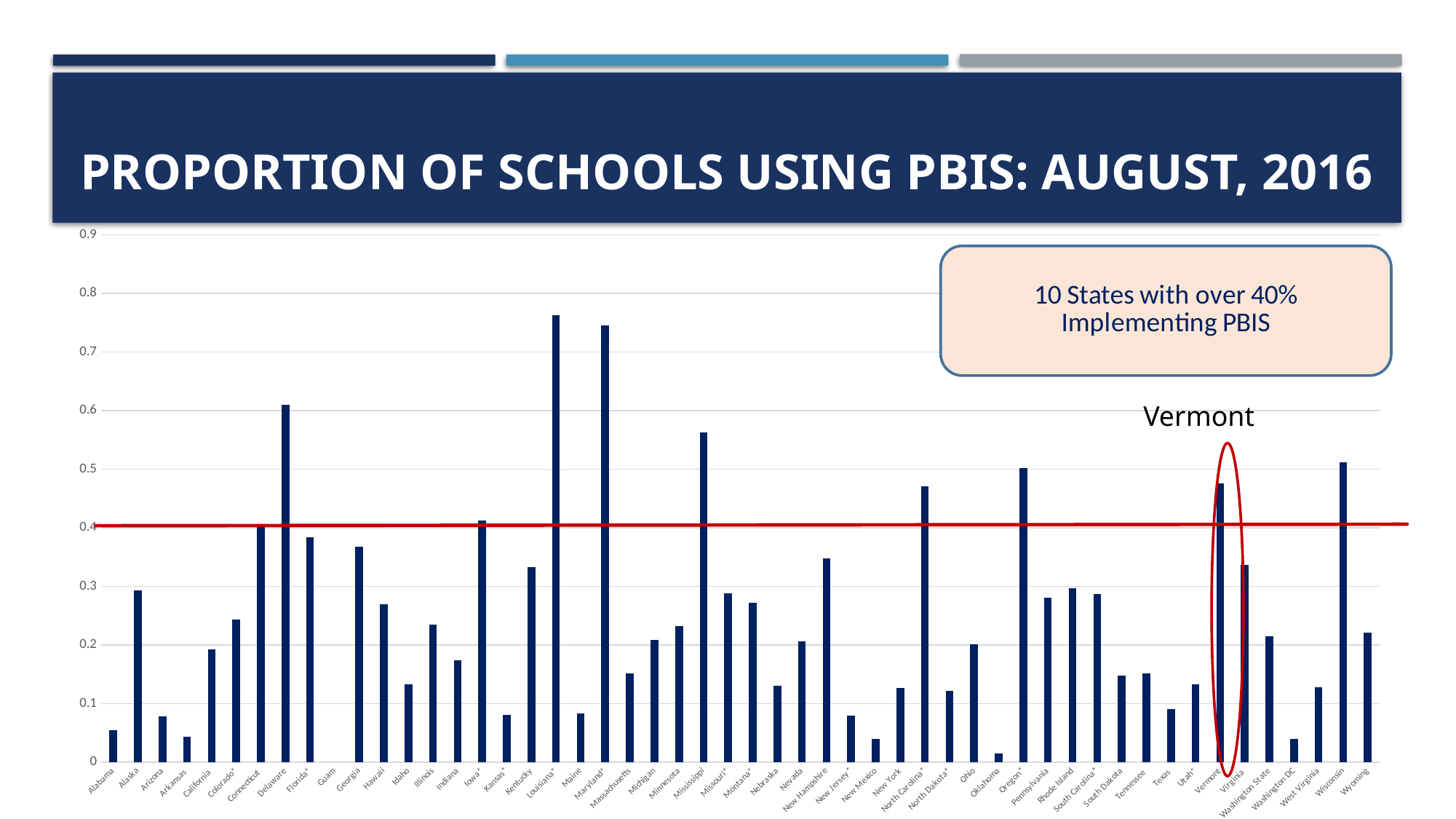
Is the value for Georgia greater or less than 0.4? less Is the value for Alabama greater or less than 0.1? less Which has the larger value, Delaware or Florida*? Delaware What kind of chart is shown on the slide? Bar chart Which state is circled in red on the chart? Vermont Is the value for Delaware greater or less than 0.5? greater Which has the larger value, Maryland* or Mississippi? Maryland* At what value on the y axis is the red horizontal line drawn? 0.4 Which has the larger value, Alaska or Louisiana*? Louisiana*